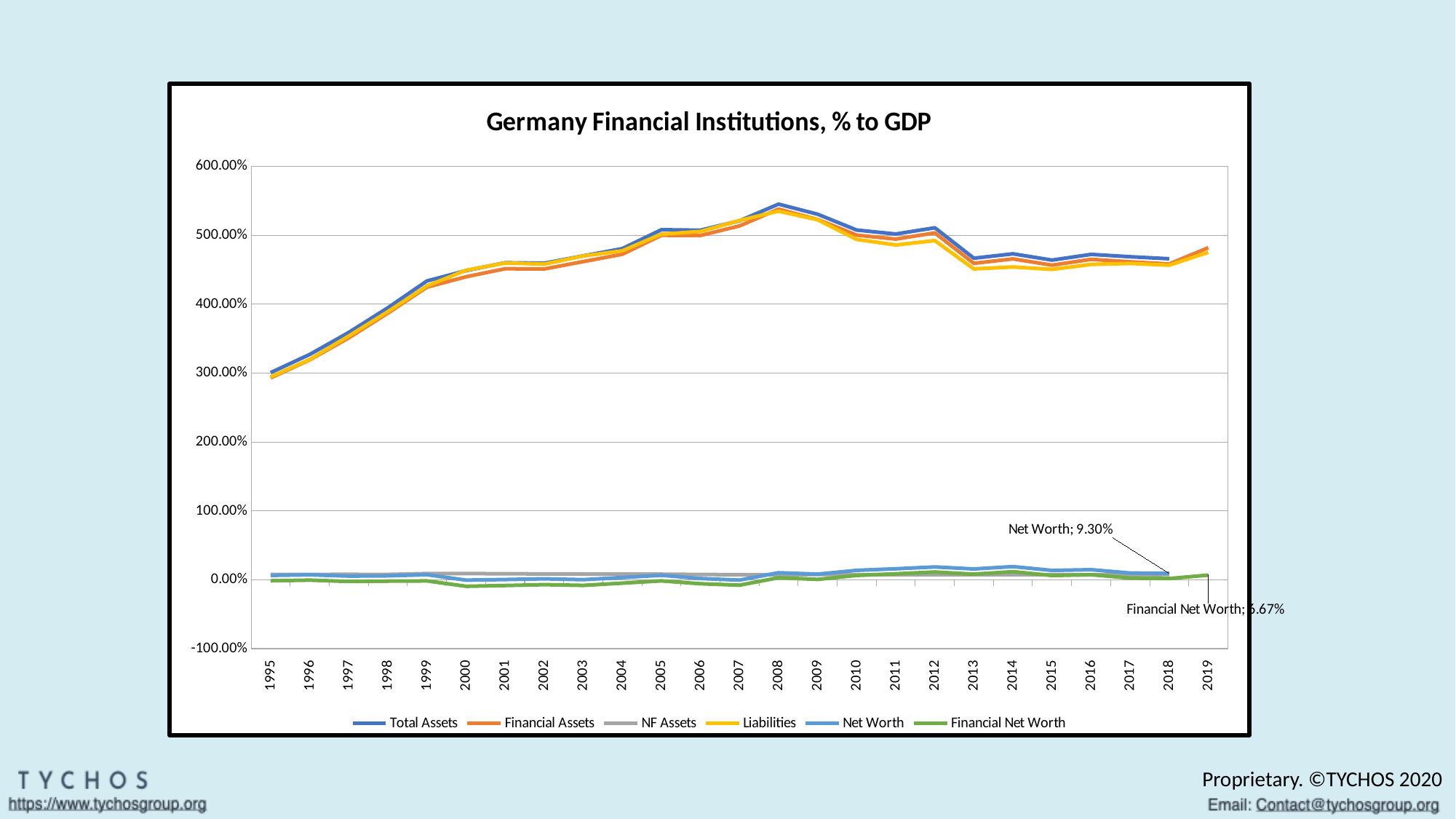
Is the value of Total Assets in 2008 greater or less than 500.00%? greater What value does the data label for Net Worth show? 9.30% How many series does the legend list? 6 Does Total Assets rise or fall from 1995 to 2008? rise What value does the data label for Financial Net Worth show? 6.67% What kind of chart is shown on the slide? line chart Which is larger, Total Assets in 1995 or Total Assets in 2008? 2008 How many years are plotted along the x axis? 25 What is the title of the chart? Germany Financial Institutions, % to GDP In which year is Total Assets at its lowest value? 1995 Is the value of Total Assets in 2013 greater or less than 500.00%? less In which year does Total Assets reach its highest value? 2008